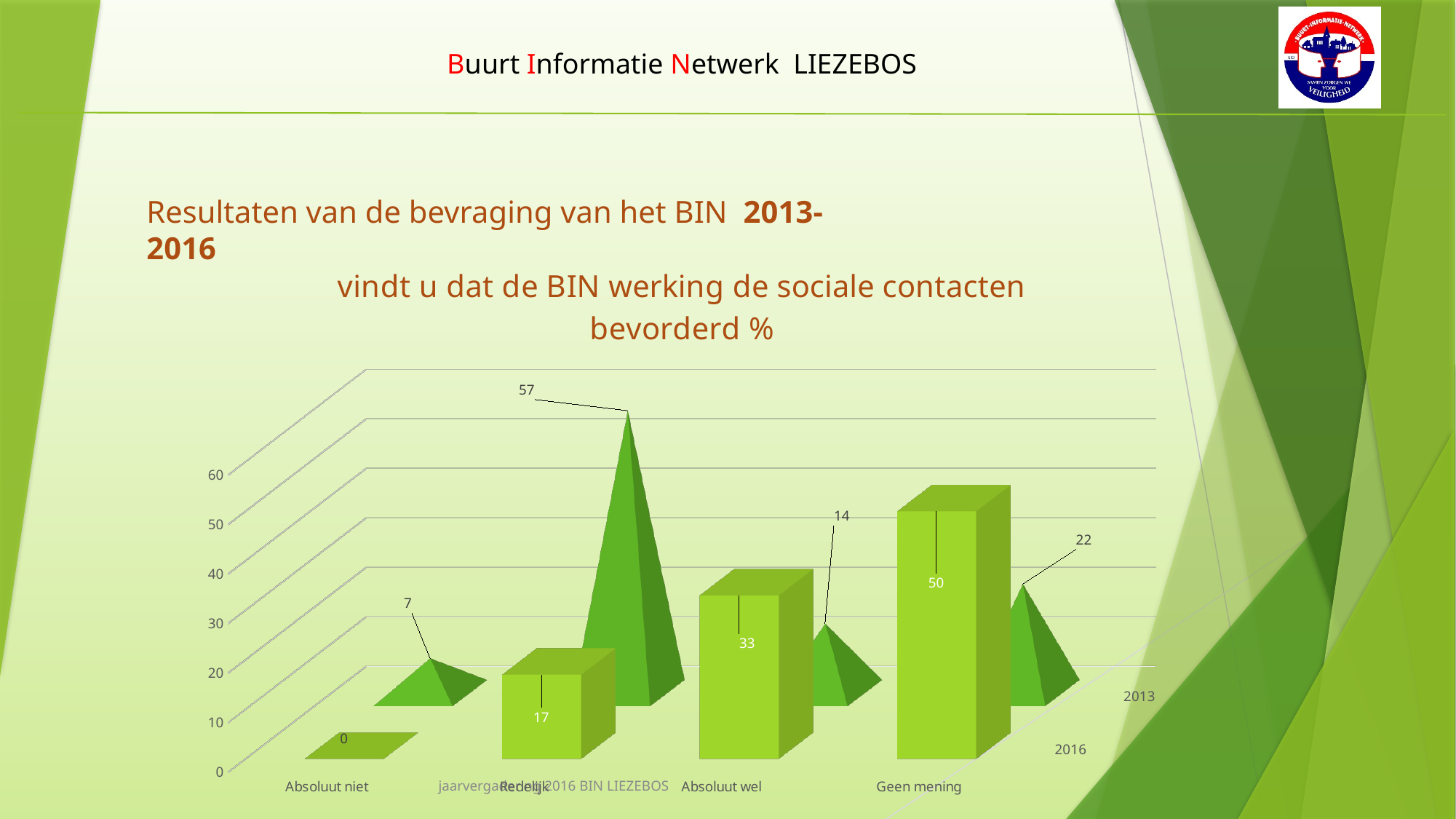
What is the value for Absoluut wel in the 2016 series? 33 What is the difference between the 2013 and 2016 values for Redelijk? 40 How many data series does the chart show? 2 Which category has the highest value in the 2013 series? Redelijk Which category has the lowest value in the 2016 series? Absoluut niet Do the values in the 2016 series rise or fall from Absoluut niet to Geen mening? rise What is the value for Geen mening in the 2016 series? 50 Which is larger for Absoluut wel: the 2013 value or the 2016 value? 2016 What is the value for Redelijk in the 2013 series? 57 What kind of chart is shown on the slide? bar chart What is the value for Absoluut niet in the 2013 series? 7 How many categories are shown on the x axis? 4